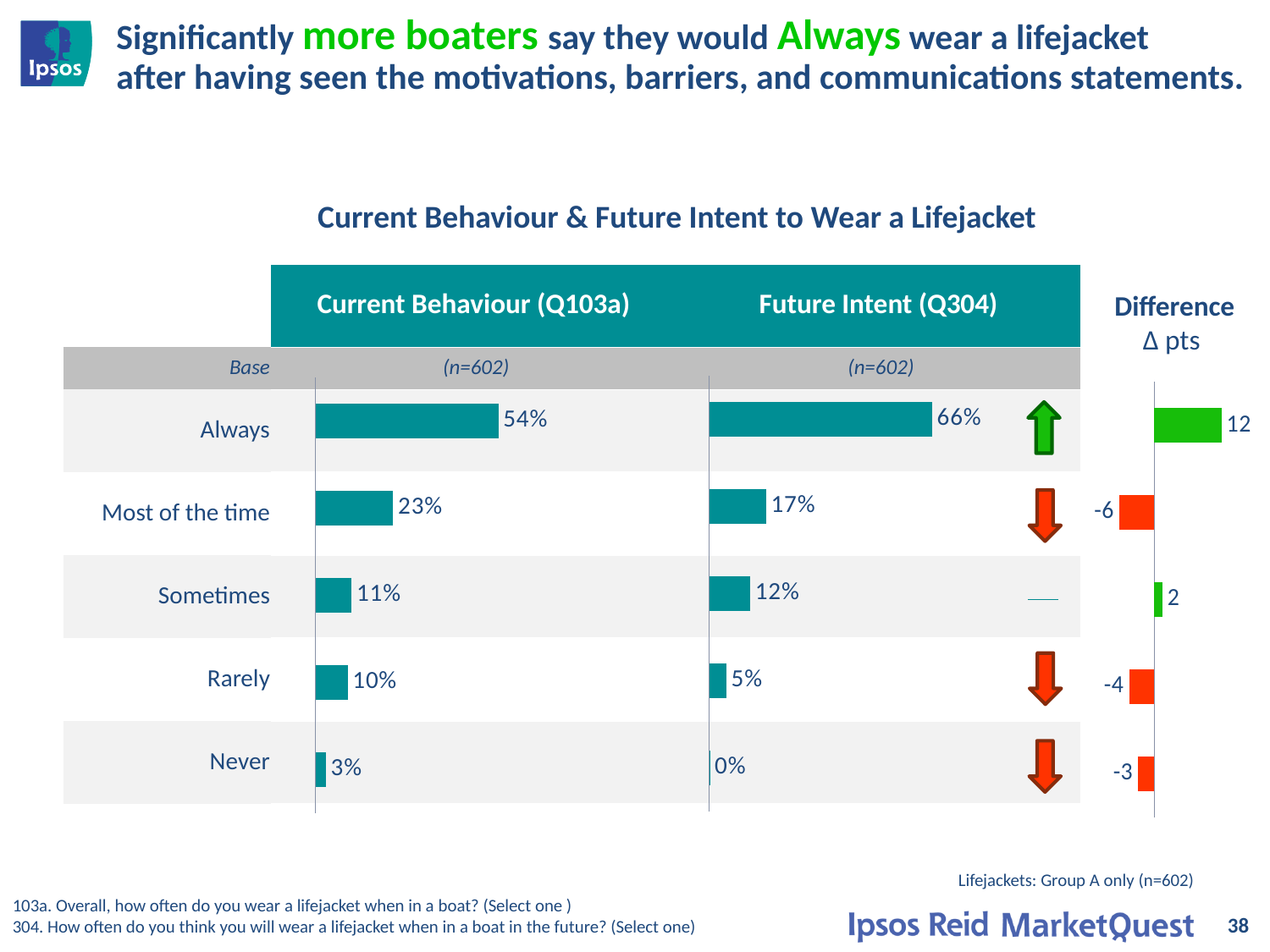
In the Current Behaviour (Q103a) chart, what percentage of boaters say they Always wear a lifejacket? 54% In the Current Behaviour (Q103a) chart, what is the value for Rarely? 10% Which is larger: the Current Behaviour (Q103a) value for Most of the time or the Future Intent (Q304) value for Most of the time? Current Behaviour (Q103a) In the Current Behaviour (Q103a) chart, which category has the highest value? Always In the Difference chart, which category has the largest positive difference? Always In the Future Intent (Q304) chart, what is the value for Never? 0% What type of chart is the Current Behaviour (Q103a) chart? Bar chart In the Difference chart, what is the value for Most of the time? -6 What is the difference between the Future Intent (Q304) and Current Behaviour (Q103a) values for Always? 12 How many categories are shown in the Current Behaviour (Q103a) chart? 5 In the Future Intent (Q304) chart, which category has the lowest value? Never In the Future Intent (Q304) chart, what percentage of boaters say they will Always wear a lifejacket? 66%